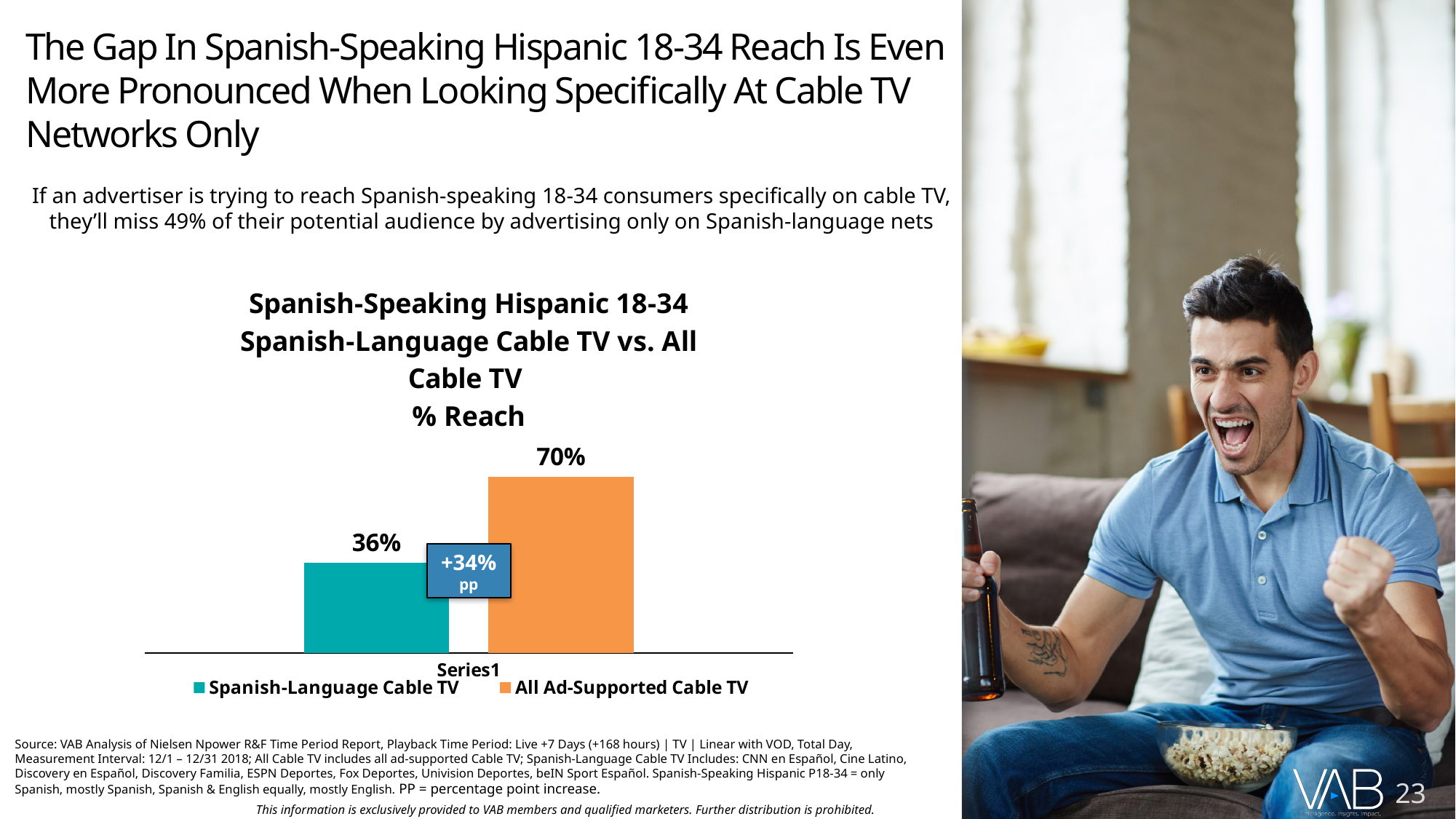
What colour is the bar for All Ad-Supported Cable TV? orange What is the % reach for All Ad-Supported Cable TV? 70% What is the % reach for Spanish-Language Cable TV? 36% Which series has the higher % reach? All Ad-Supported Cable TV How many bars are plotted in the chart? 2 How many series does the legend list? 2 What is the difference in % reach between All Ad-Supported Cable TV and Spanish-Language Cable TV? 34 percentage points What percentage point increase is shown in the callout box between the two bars? +34% pp Is the % reach for All Ad-Supported Cable TV larger or smaller than that for Spanish-Language Cable TV? larger Which series has the lower % reach? Spanish-Language Cable TV What kind of chart is shown on the slide? bar chart